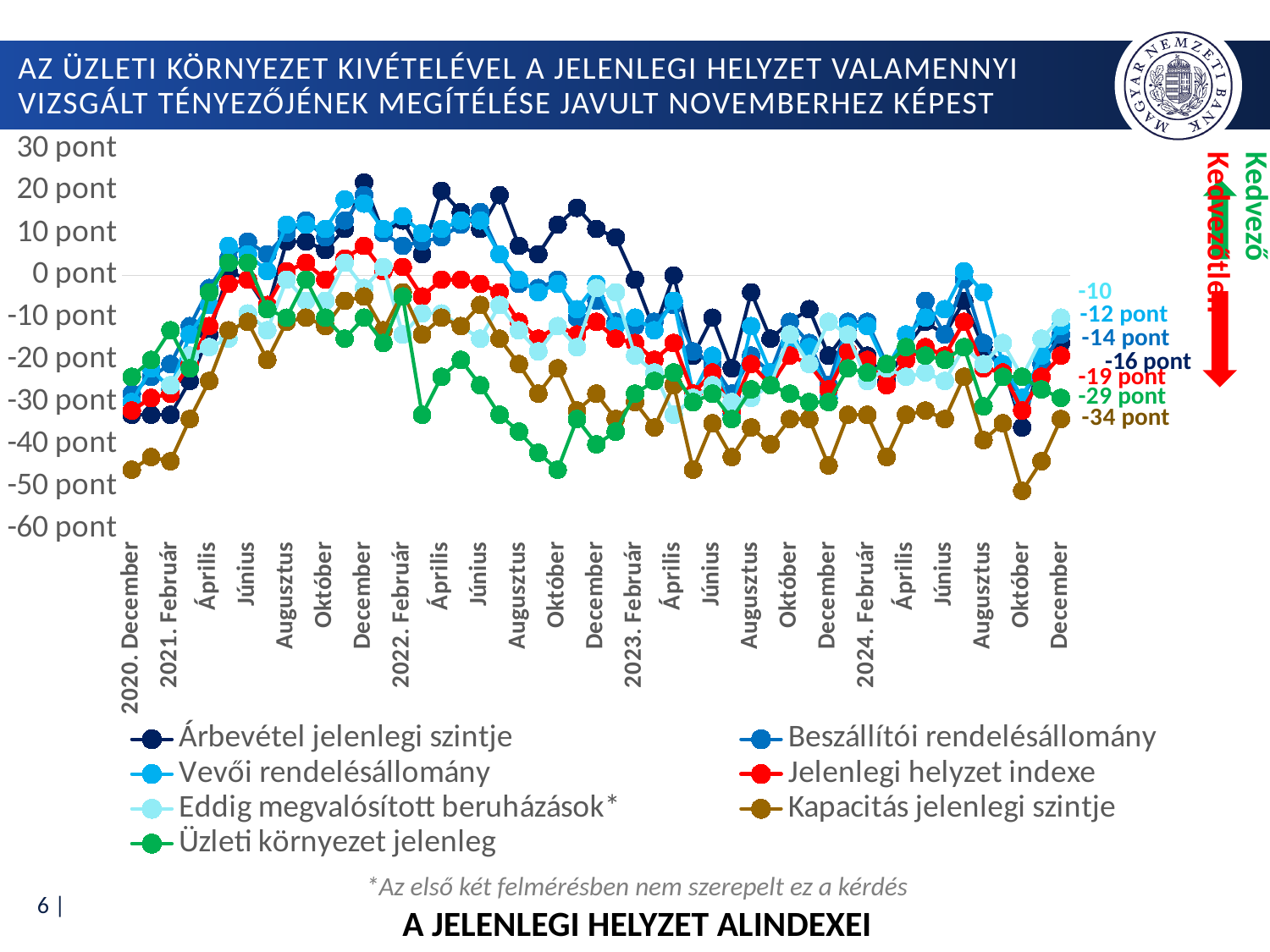
At the end of the chart (December 2024), which series has the larger value: 'Beszállítói rendelésállomány' or 'Üzleti környezet jelenleg'? Beszállítói rendelésállomány Which series has the highest labelled value at the end of the chart (December 2024)? Eddig megvalósított beruházások* What is the difference between the final labelled values of 'Jelenlegi helyzet indexe' (-19 pont) and 'Kapacitás jelenlegi szintje' (-34 pont)? 15 pont What is the final labelled value (December 2024) for the series 'Jelenlegi helyzet indexe'? -19 pont Which series has the lowest labelled value at the end of the chart (December 2024)? Kapacitás jelenlegi szintje What is the final labelled value (December 2024) for the series 'Vevői rendelésállomány'? -12 pont What is the final labelled value (December 2024) for the series 'Üzleti környezet jelenleg'? -29 pont What is the title printed below the chart? A JELENLEGI HELYZET ALINDEXEI What is the final labelled value (December 2024) for the series 'Árbevétel jelenlegi szintje'? -16 pont What kind of chart is shown on the slide? line chart What is the final labelled value (December 2024) for the series 'Kapacitás jelenlegi szintje'? -34 pont How many series does the legend list? 7